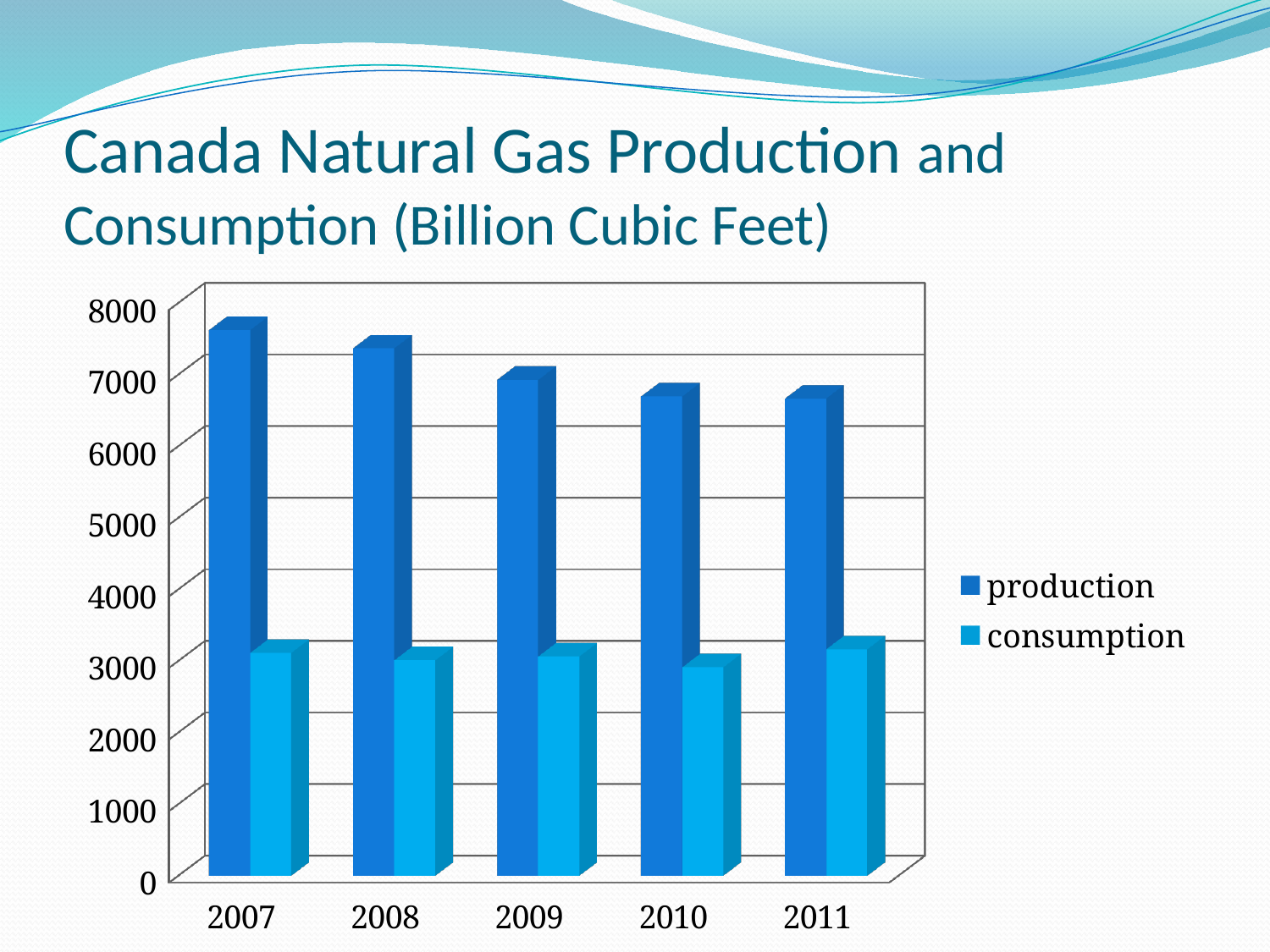
Is the production value for 2007 greater or less than 7000? greater How many years are shown on the x axis of the chart? 5 Which is larger in 2011, production or consumption? production Is the consumption value for 2009 greater or less than 4000? less What kind of chart is shown on the slide? bar chart Which year has the highest production value? 2007 Is the production value for 2011 greater or less than 6000? greater Which is larger, production in 2007 or production in 2008? production in 2007 How many series does the chart's legend list? 2 Does the production series rise or fall from 2007 to 2011? fall What are the two entries in the chart's legend? production and consumption